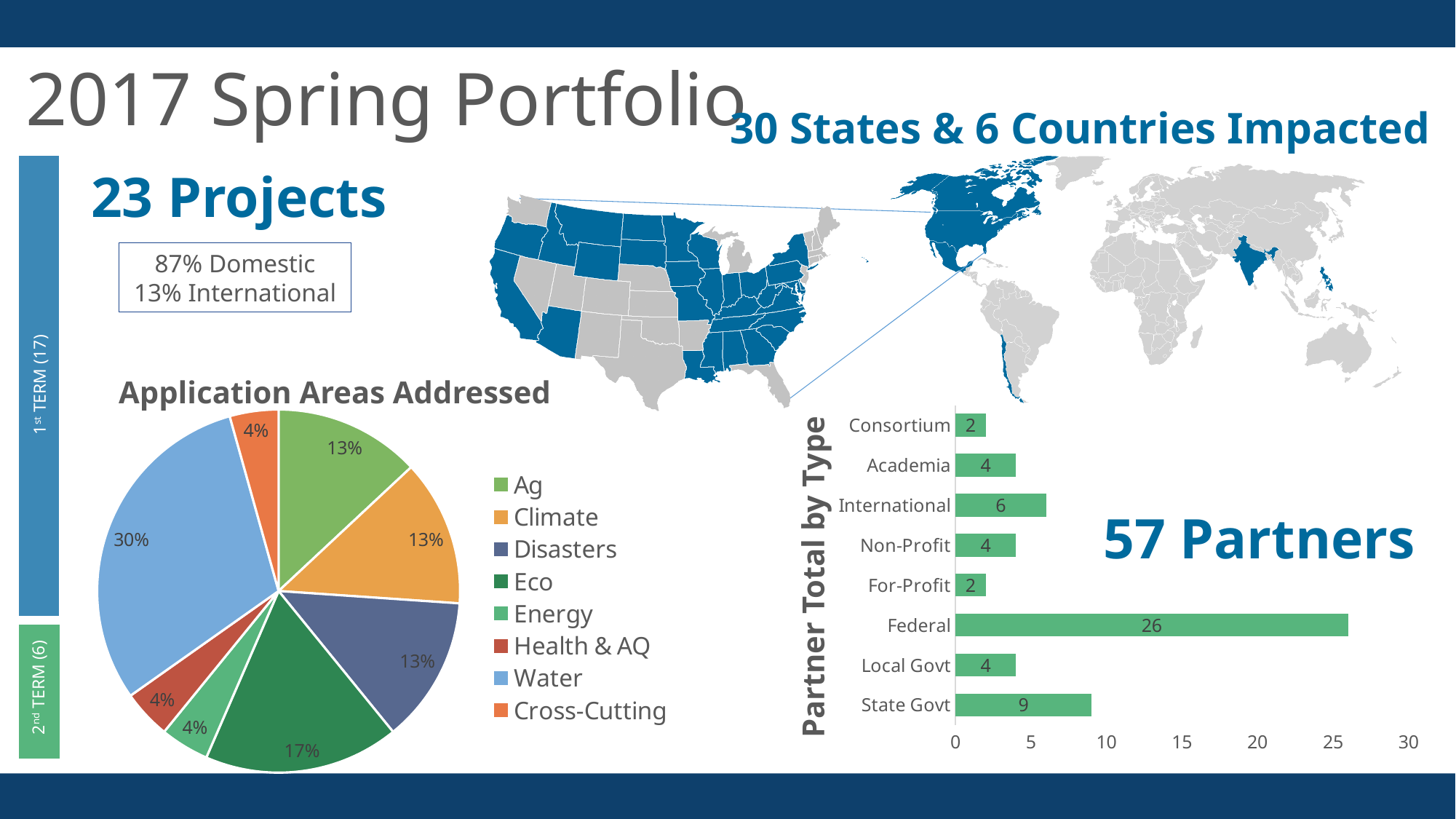
In the Partner Total by Type chart, which partner type has the highest value? Federal How many partner types are listed in the Partner Total by Type chart? 8 In the Application Areas Addressed chart, what share does Water have? 30% In the Partner Total by Type chart, how many Federal partners are shown? 26 In the Application Areas Addressed chart, what percentage is Eco? 17% What kind of chart is the Application Areas Addressed chart? Pie chart In the Application Areas Addressed chart, which application area has the largest share? Water In the Partner Total by Type chart, which is larger, International or Academia? International In the Partner Total by Type chart, what is the difference between Federal and State Govt? 17 What kind of chart is the Partner Total by Type chart? Bar chart In the Partner Total by Type chart, what is the value for State Govt? 9 How many application areas are listed in the legend of the Application Areas Addressed chart? 8